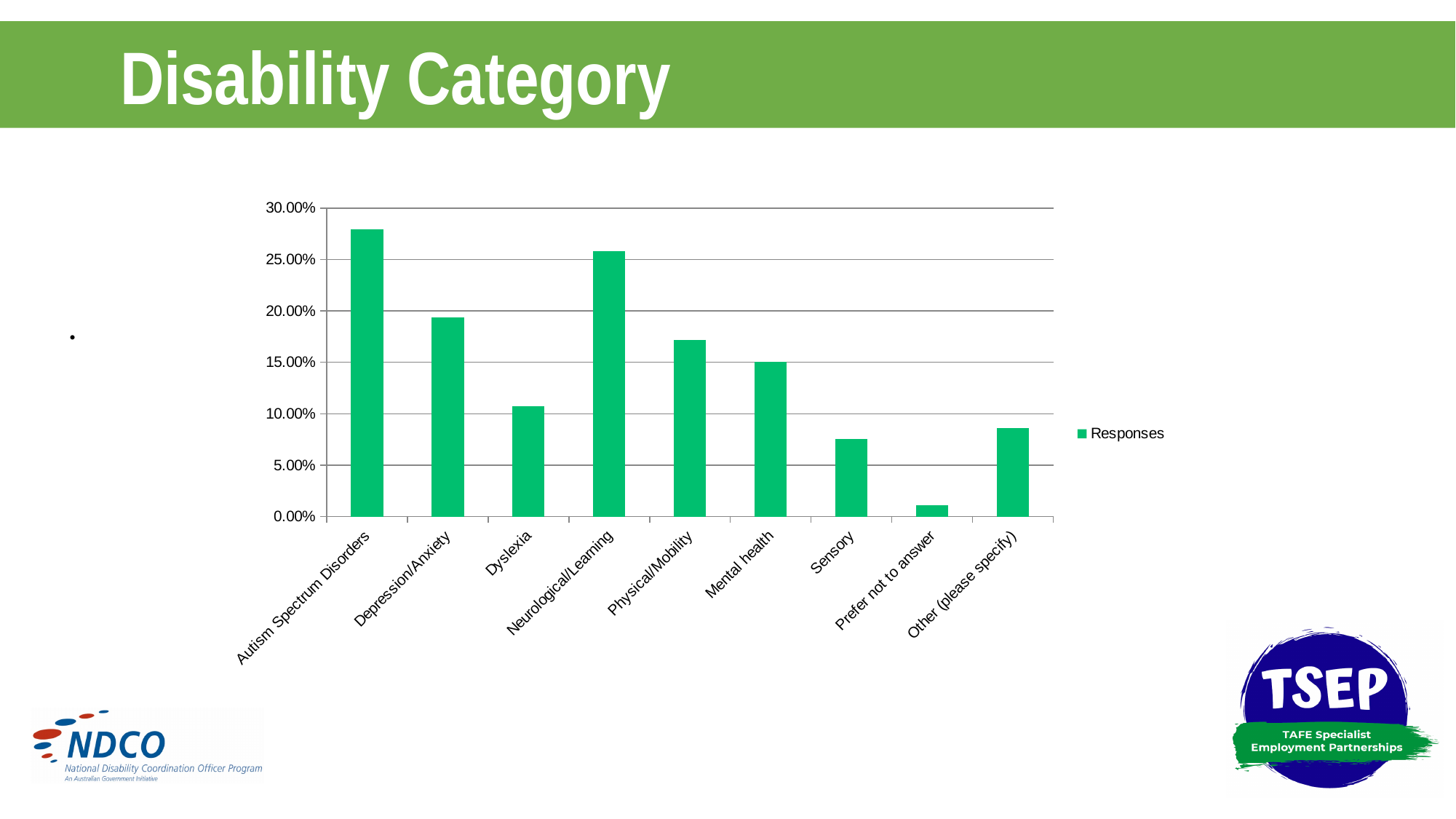
Which disability category has the lowest share of responses? Prefer not to answer Which is larger, the value for Depression/Anxiety or the value for Physical/Mobility? Depression/Anxiety Is the value for Dyslexia greater or less than 15.00%? less Which disability category has the highest share of responses? Autism Spectrum Disorders Is the value for Sensory greater or less than 10.00%? less What kind of chart is shown on the slide? Bar chart Is the value for Autism Spectrum Disorders greater or less than 25.00%? greater Which is larger, the value for Dyslexia or the value for Mental health? Mental health How many disability categories are shown on the x axis? 9 How many series does the legend list? 1 What is the name of the series shown in the legend? Responses